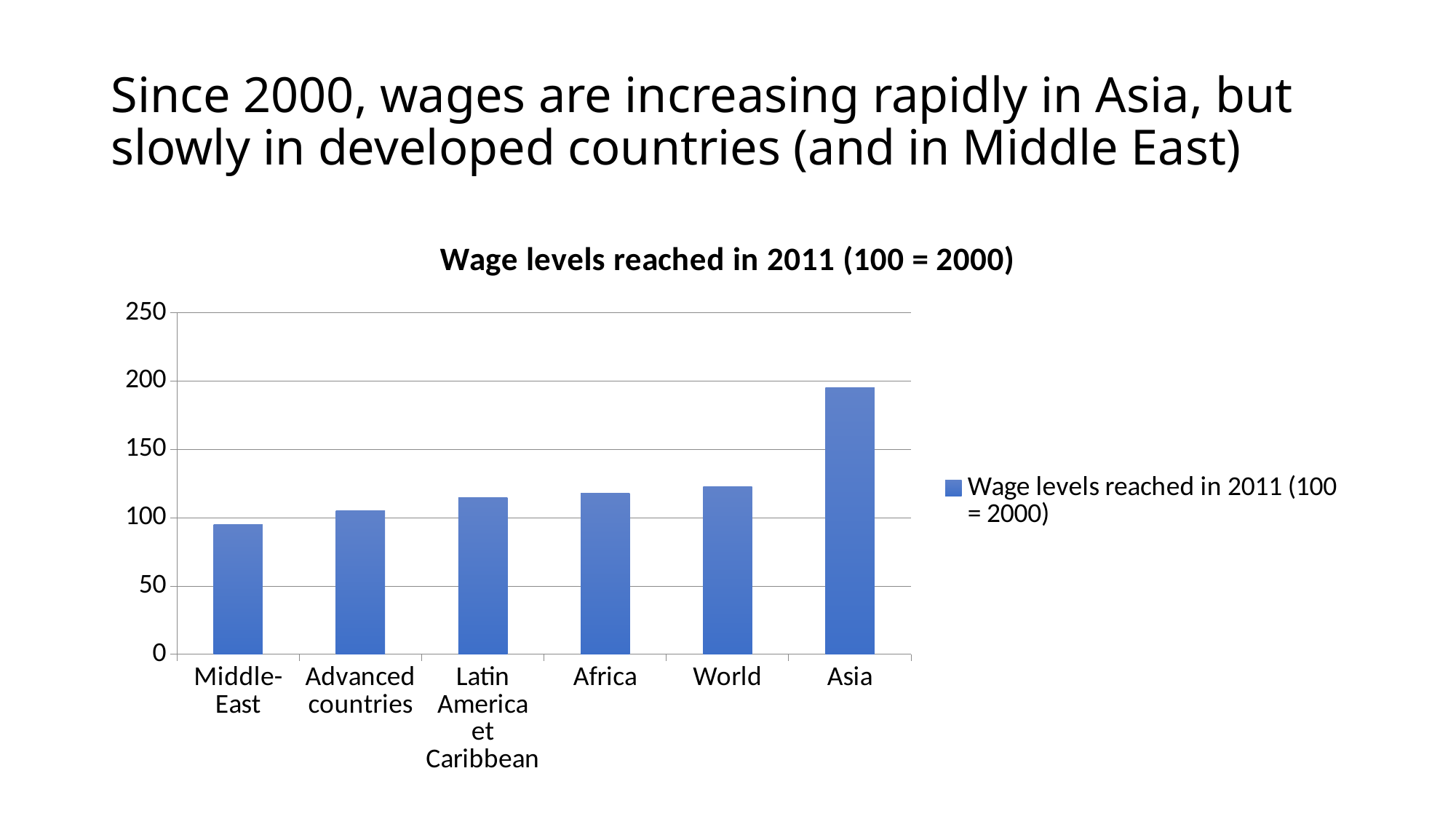
Which category has the highest wage level reached in 2011? Asia Is the value for Asia greater or less than 150? greater What is the title of the chart? Wage levels reached in 2011 (100 = 2000) Which category has the lowest wage level reached in 2011? Middle-East How many series does the legend list? 1 Which is larger, the value for Asia or the value for World? Asia Is the value for Middle-East greater or less than 100? less What kind of chart is shown on the slide? bar chart Is the value for Africa greater or less than 100? greater Do the values generally rise or fall moving from left to right along the x axis? rise How many categories are shown on the x axis of the chart? 6